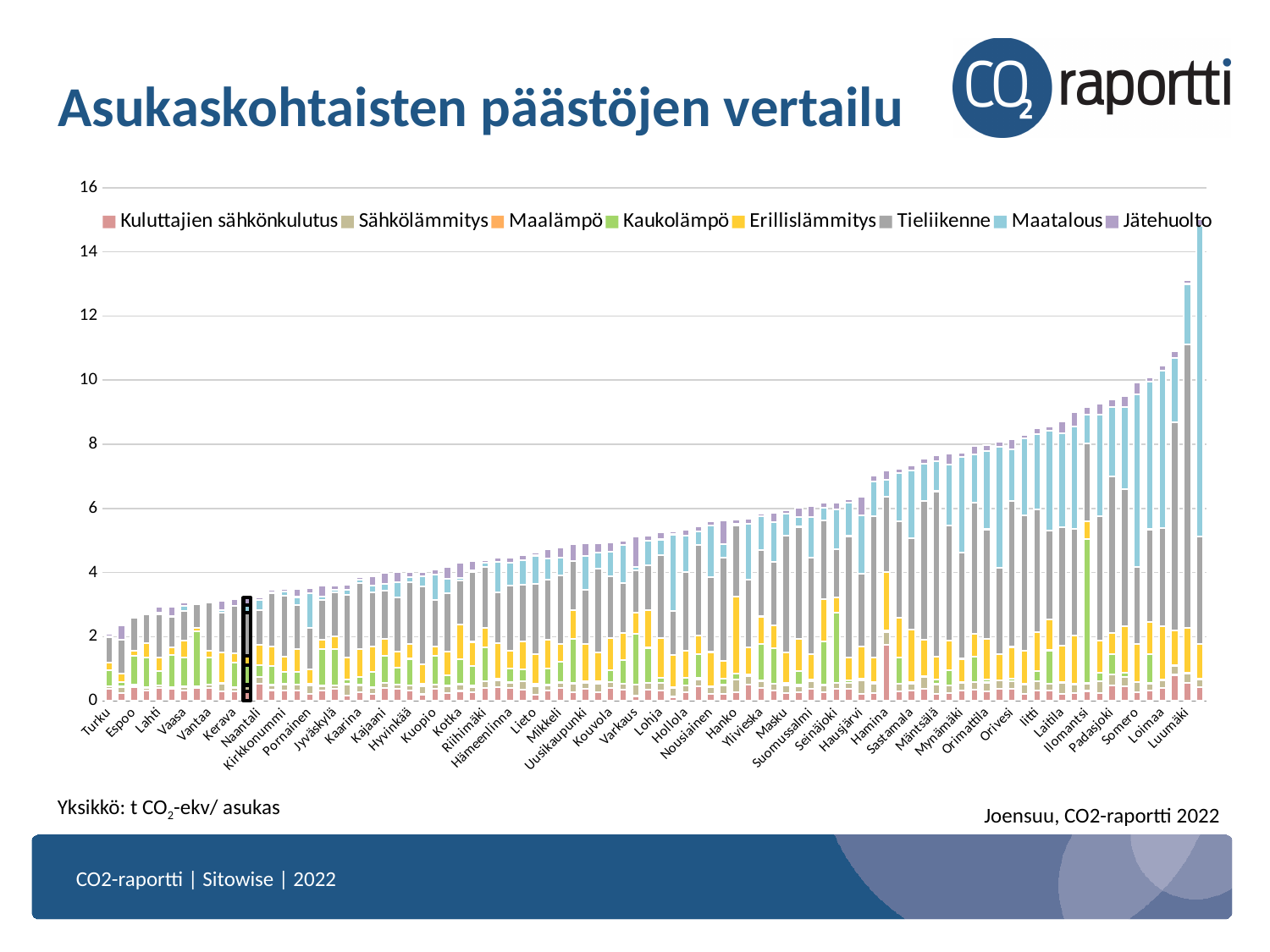
What is the title of the chart on the slide? Asukaskohtaisten päästöjen vertailu Do the total bar heights rise or fall from left to right along the x axis? Rise Is the total value for Luumäki greater or less than 14? less Which legend entry is shown in light blue? Maatalous Is the total value for Turku greater or less than 4? less Which has a larger total bar, Luumäki or Turku? Luumäki What kind of chart is shown on the slide? Stacked bar chart Is the total value for Hamina greater or less than 6? greater How many series does the legend list? 8 Which municipality has the lowest total per-capita emissions in the chart? Turku